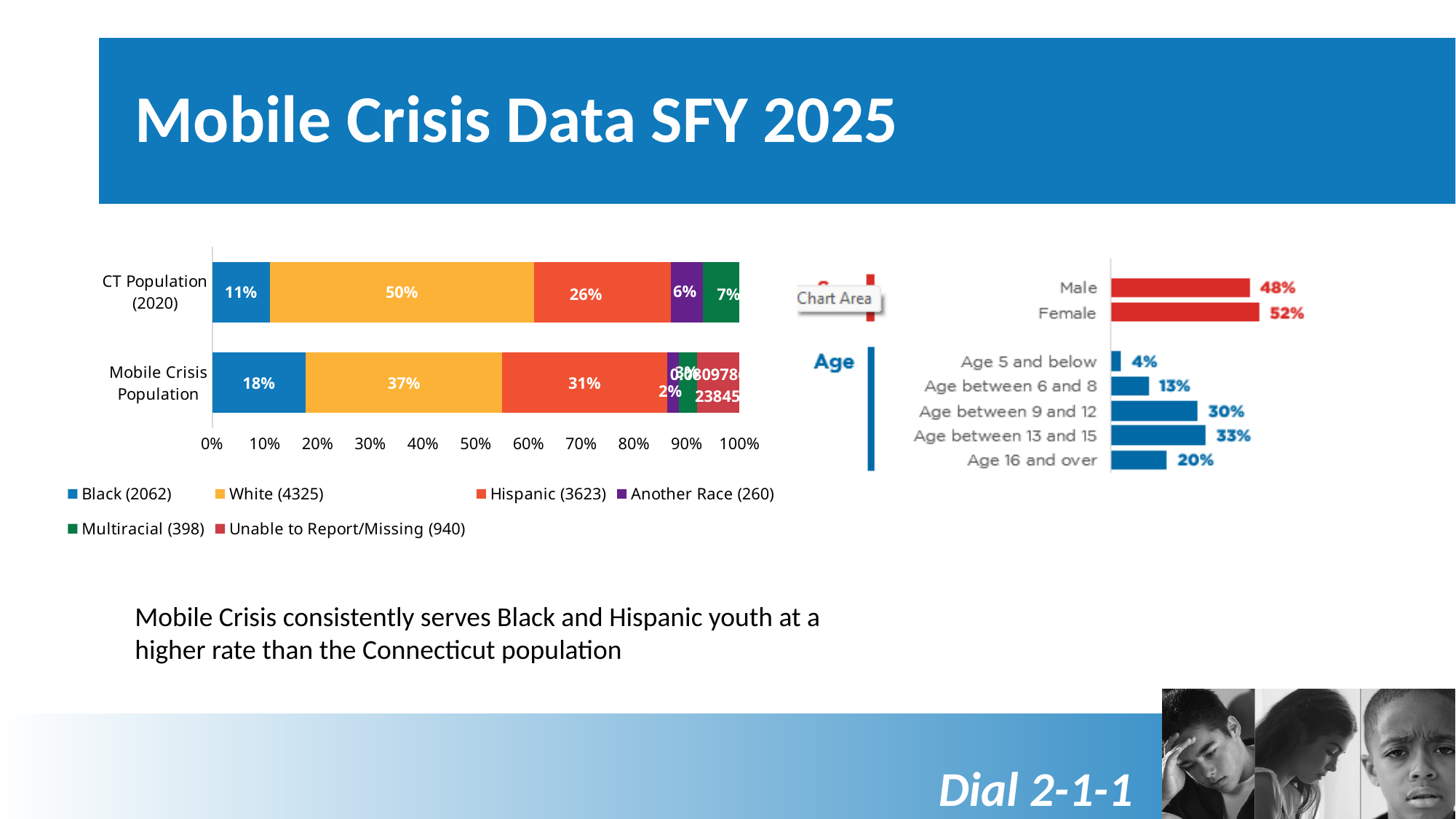
In the right chart, which age group has the lowest percentage? Age 5 and below In the right chart, what percentage is Female? 52% In the right chart, how many age groups are shown? 5 What kind of chart is the left chart comparing CT Population and Mobile Crisis Population? Stacked bar chart How many series does the legend of the left stacked bar chart list? 6 In the left stacked bar chart, what percentage of the Mobile Crisis Population is Hispanic? 31% In the left stacked bar chart, is the Hispanic share larger for the CT Population (2020) or the Mobile Crisis Population? Mobile Crisis Population In the left stacked bar chart, how many percentage points higher is the Black share of the Mobile Crisis Population than of the CT Population (2020)? 7 percentage points In the left stacked bar chart, what percentage of the CT Population (2020) is White? 50% In the right chart, which age group has the highest percentage? Age between 13 and 15 In the left stacked bar chart, what percentage of the Mobile Crisis Population is Black? 18% In the left stacked bar chart, what percentage of the CT Population (2020) is Another Race? 6%